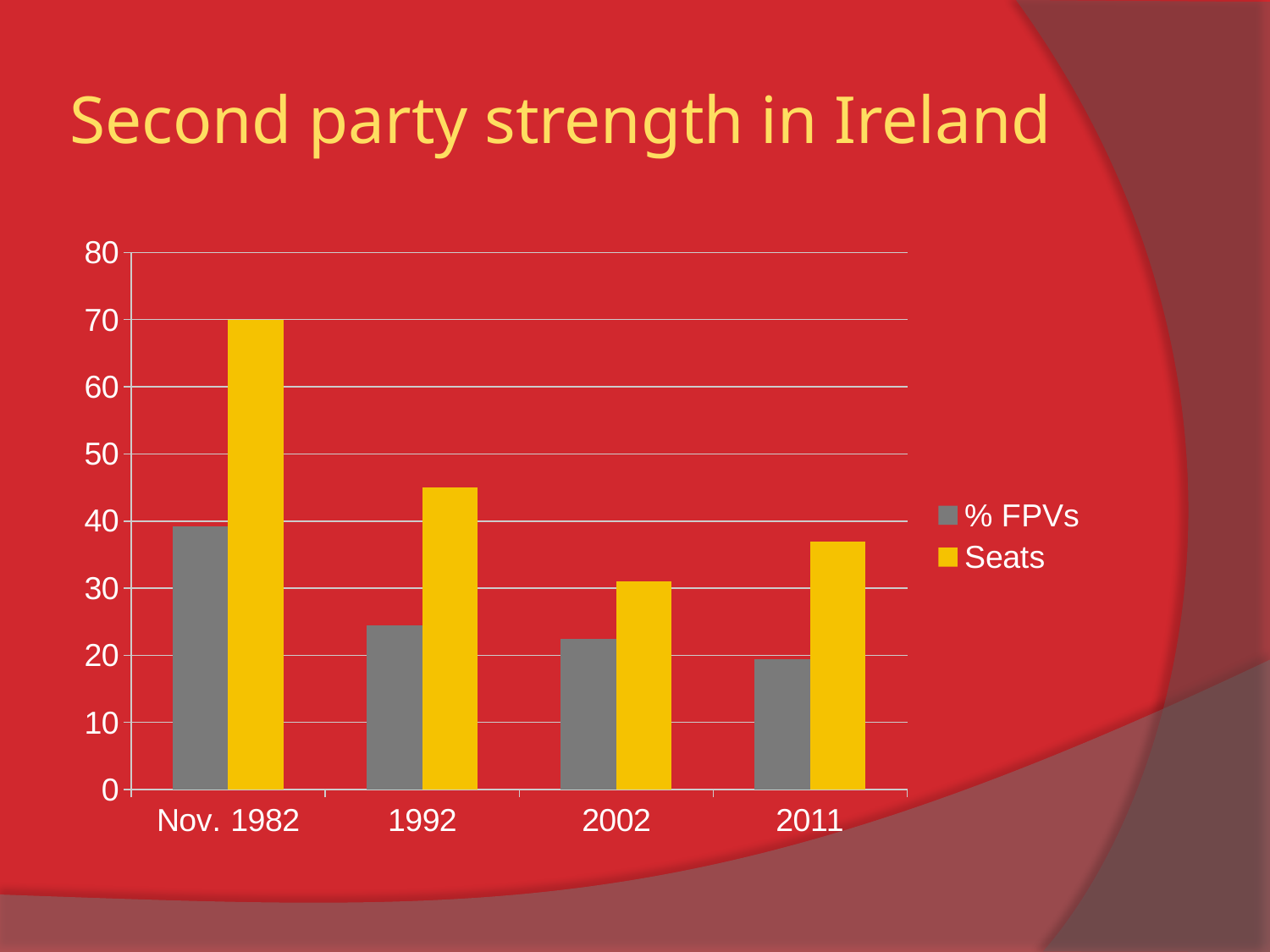
Which is larger, the Seats value for 1992 or the Seats value for 2011? 1992 How many categories are shown on the x axis? 4 How many series does the legend list? 2 What is the Seats value for Nov. 1982? 70 Which category has the lowest Seats value? 2002 What kind of chart is shown on the slide? bar chart Is the % FPVs value for Nov. 1982 greater or less than 30? greater Is the % FPVs value for 1992 greater or less than 30? less Is the Seats value for 2011 greater or less than 30? greater Which category has the lowest % FPVs value? 2011 Which category has the highest Seats value? Nov. 1982 Do the % FPVs values rise or fall from Nov. 1982 to 2011? fall